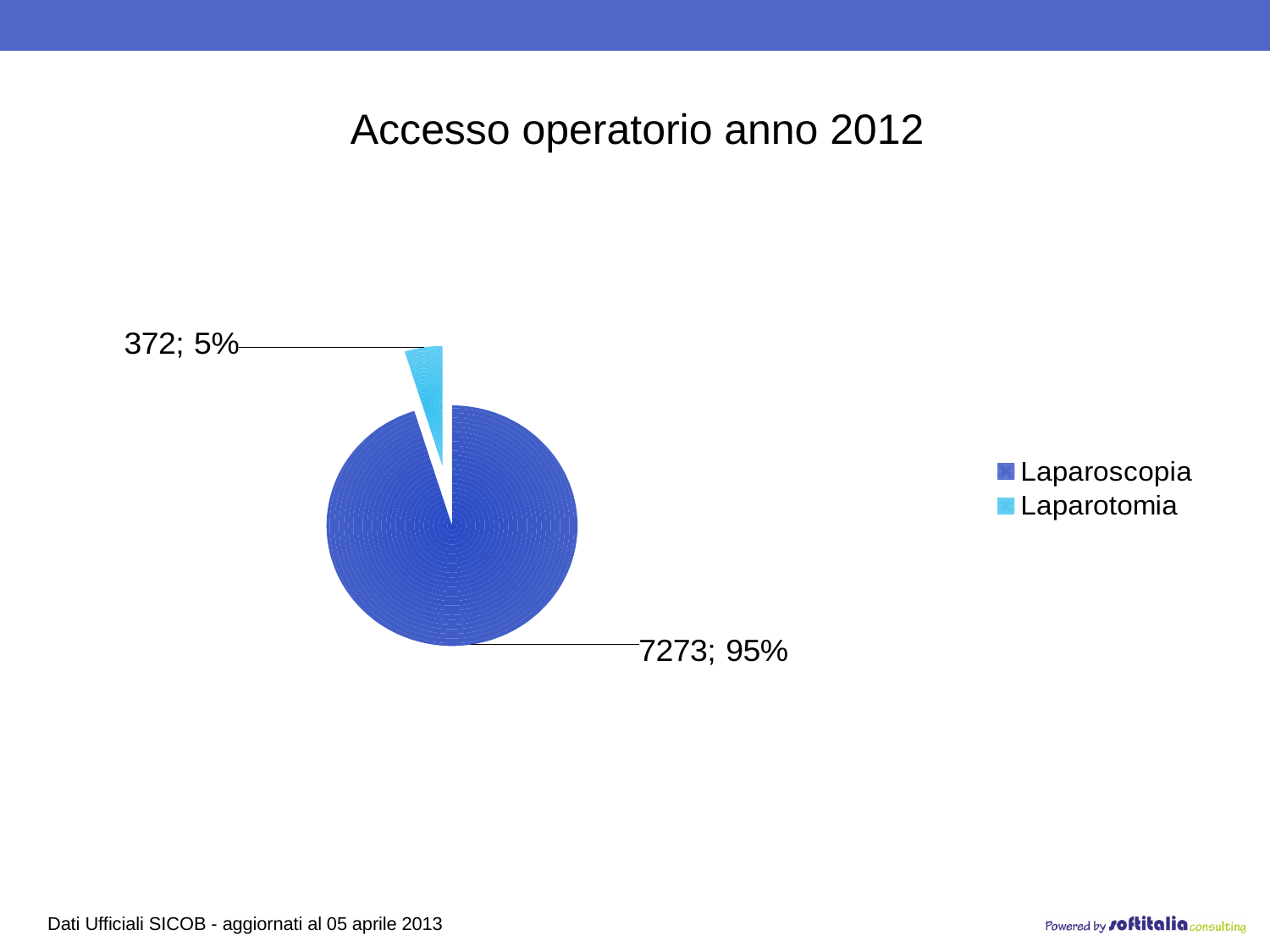
What is the difference between the values for Laparoscopia and Laparotomia? 6901 How many entries does the legend list? 2 What is the value for Laparoscopia? 7273 What is the total of the two slices in the pie chart? 7645 Which category has the largest slice? Laparoscopia How many slices does the pie chart have? 2 Which category has the smallest slice? Laparotomia What share of the pie does Laparoscopia represent? 95% What is the title of the chart? Accesso operatorio anno 2012 What is the value for Laparotomia? 372 What share of the pie does Laparotomia represent? 5% What kind of chart is shown on the slide? pie chart